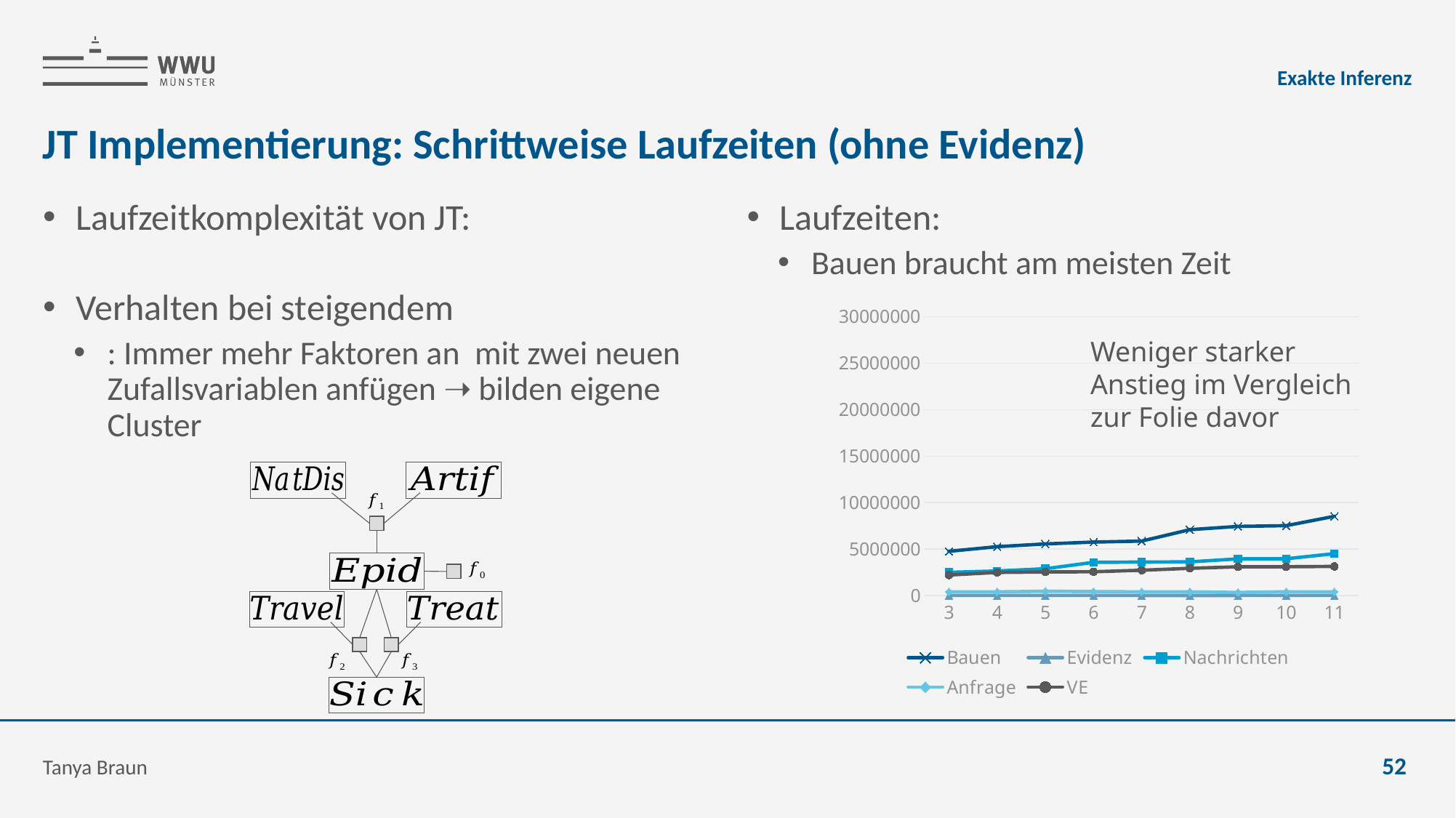
Which series has the highest value at x = 11? Bauen Is the value of VE at x = 3 greater or less than 5000000? less Is the value of Bauen at x = 11 greater or less than 10000000? less Is the value of Nachrichten at x = 11 greater or less than 5000000? less At x = 11, which is larger: Bauen or VE? Bauen How many series does the chart's legend list? 5 At x = 11, which is larger: Nachrichten or VE? Nachrichten Does the Bauen series rise or fall as x increases from 3 to 11? rise What kind of chart is shown on the slide? line chart How many x-axis values are plotted in the chart? 9 What is the highest value shown on the chart's y axis? 30000000